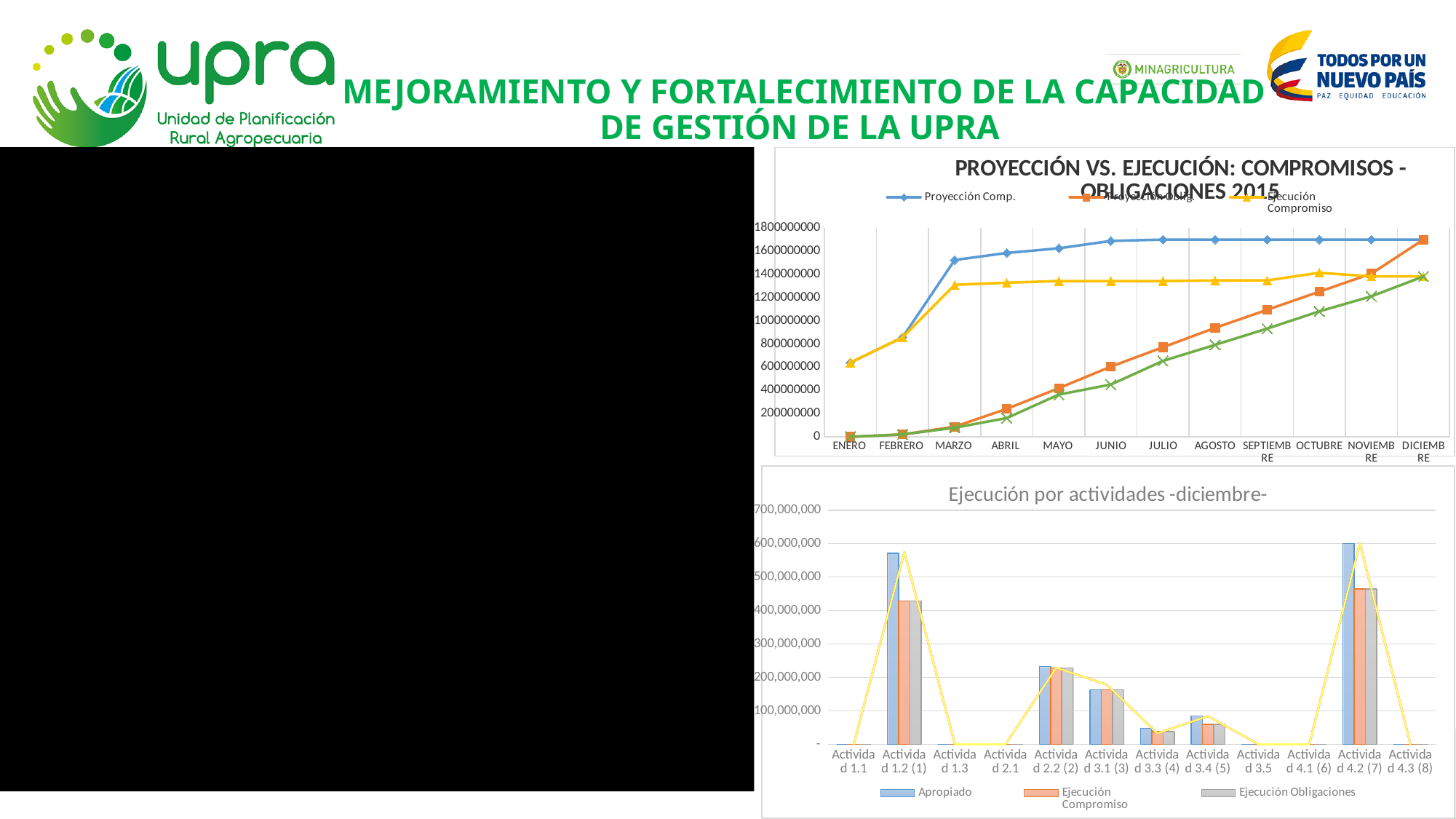
In the bottom chart 'Ejecución por actividades -diciembre-', how many activities are listed on the x axis? 12 What kind of chart is the top chart titled 'PROYECCIÓN VS. EJECUCIÓN: COMPROMISOS - OBLIGACIONES 2015'? line chart In the top chart 'PROYECCIÓN VS. EJECUCIÓN: COMPROMISOS - OBLIGACIONES 2015', is the value of Ejecución Compromiso in ENERO greater or less than 800000000? less In the top chart 'PROYECCIÓN VS. EJECUCIÓN: COMPROMISOS - OBLIGACIONES 2015', which is larger in MARZO: Proyección Comp. or Proyección Oblig.? Proyección Comp. In the top chart 'PROYECCIÓN VS. EJECUCIÓN: COMPROMISOS - OBLIGACIONES 2015', is the value of Proyección Oblig. in JUNIO greater or less than 400000000? greater In the bottom chart 'Ejecución por actividades -diciembre-', is the Apropiado value for Actividad 1.2 (1) greater or less than 500,000,000? greater In the top chart 'PROYECCIÓN VS. EJECUCIÓN: COMPROMISOS - OBLIGACIONES 2015', how many months are shown on the x axis? 12 In the bottom chart 'Ejecución por actividades -diciembre-', how many entries does the legend list? 3 In the bottom chart 'Ejecución por actividades -diciembre-', which is larger for Apropiado: Actividad 2.2 (2) or Actividad 3.3 (4)? Actividad 2.2 (2) What kind of chart is the bottom chart titled 'Ejecución por actividades -diciembre-'? combination bar and line chart In the top chart 'PROYECCIÓN VS. EJECUCIÓN: COMPROMISOS - OBLIGACIONES 2015', does the Proyección Oblig. series rise or fall from ENERO to DICIEMBRE? rise